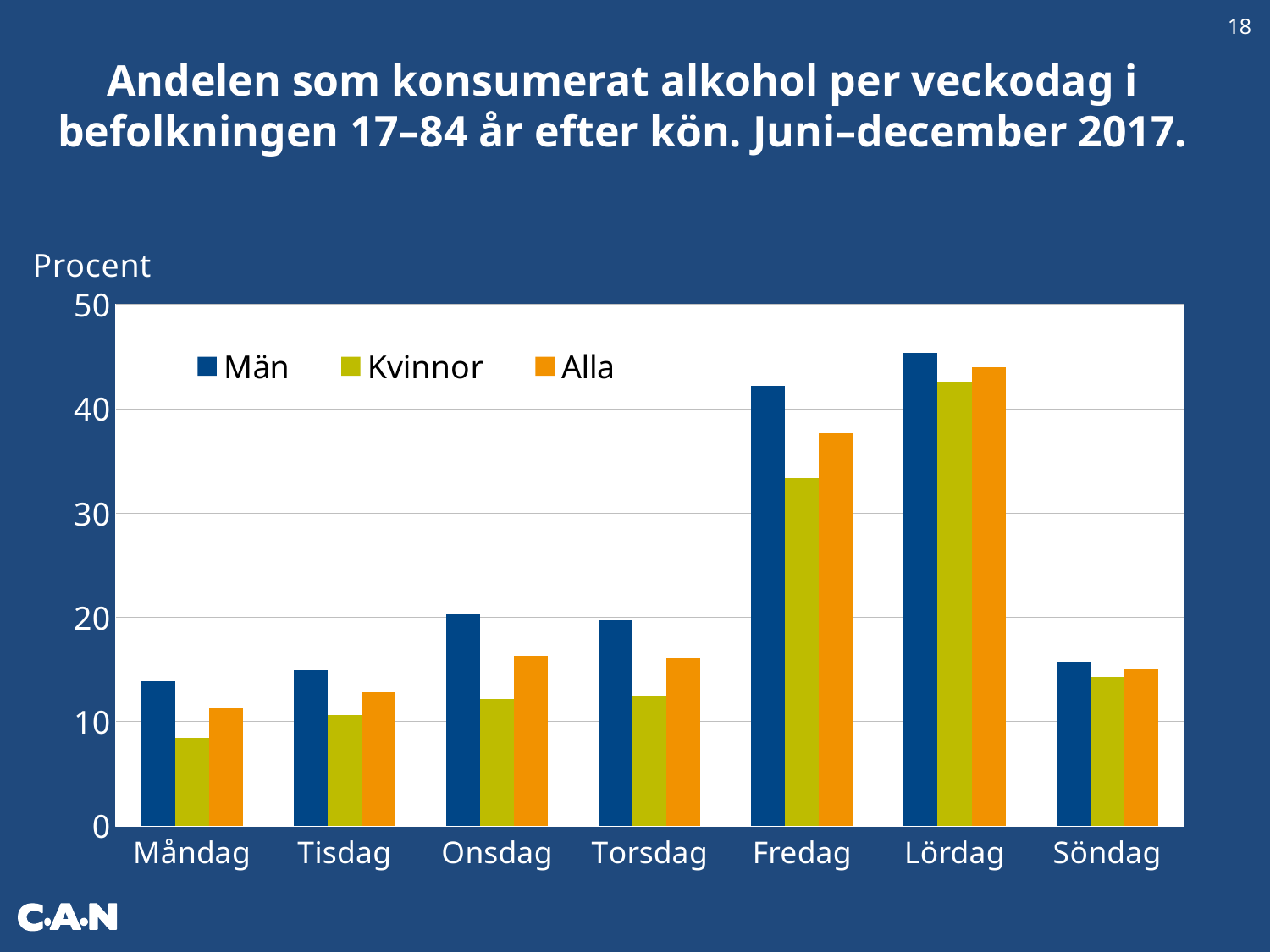
Which weekday has the highest value for Alla? Lördag Is the value for Kvinnor on Måndag greater or less than 10? less What kind of chart is shown on the slide? bar chart Is the value for Män on Fredag greater or less than 40? greater What are the three series listed in the legend? Män, Kvinnor, Alla Which weekday has the highest value for Män? Lördag How many weekdays (categories) are shown on the x axis? 7 How many series does the legend list? 3 Which is larger: the value for Män on Onsdag or the value for Män on Söndag? Onsdag Which is larger: the value for Kvinnor on Fredag or the value for Kvinnor on Lördag? Lördag Which weekday has the lowest value for Kvinnor? Måndag Is the value for Alla on Lördag greater or less than 40? greater